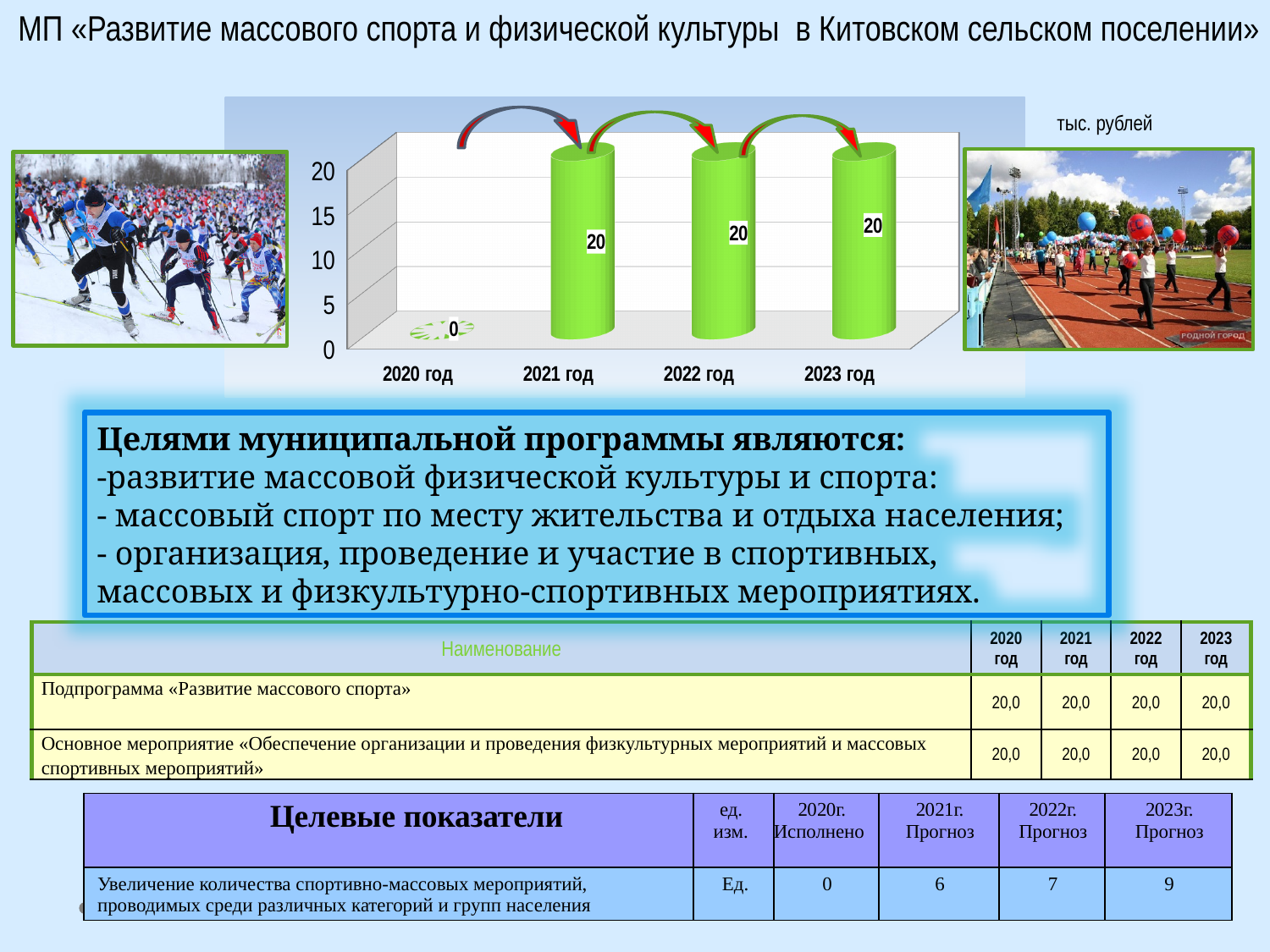
What is the value for 2020 год in the bar chart? 0 What kind of chart is shown on the slide? bar chart What is the difference between the values for 2021 год and 2020 год in the bar chart? 20 Which category has the lowest value in the bar chart? 2020 год Do the values in the bar chart rise or fall from 2020 год to 2021 год? rise Is the value for 2022 год in the bar chart greater or less than 10? greater What unit label is shown next to the bar chart? тыс. рублей What is the value for 2023 год in the bar chart? 20 What is the value for 2021 год in the bar chart? 20 How many categories are shown on the x axis of the bar chart? 4 Which is larger in the bar chart, the value for 2020 год or the value for 2022 год? 2022 год What colour are the bars in the chart? green